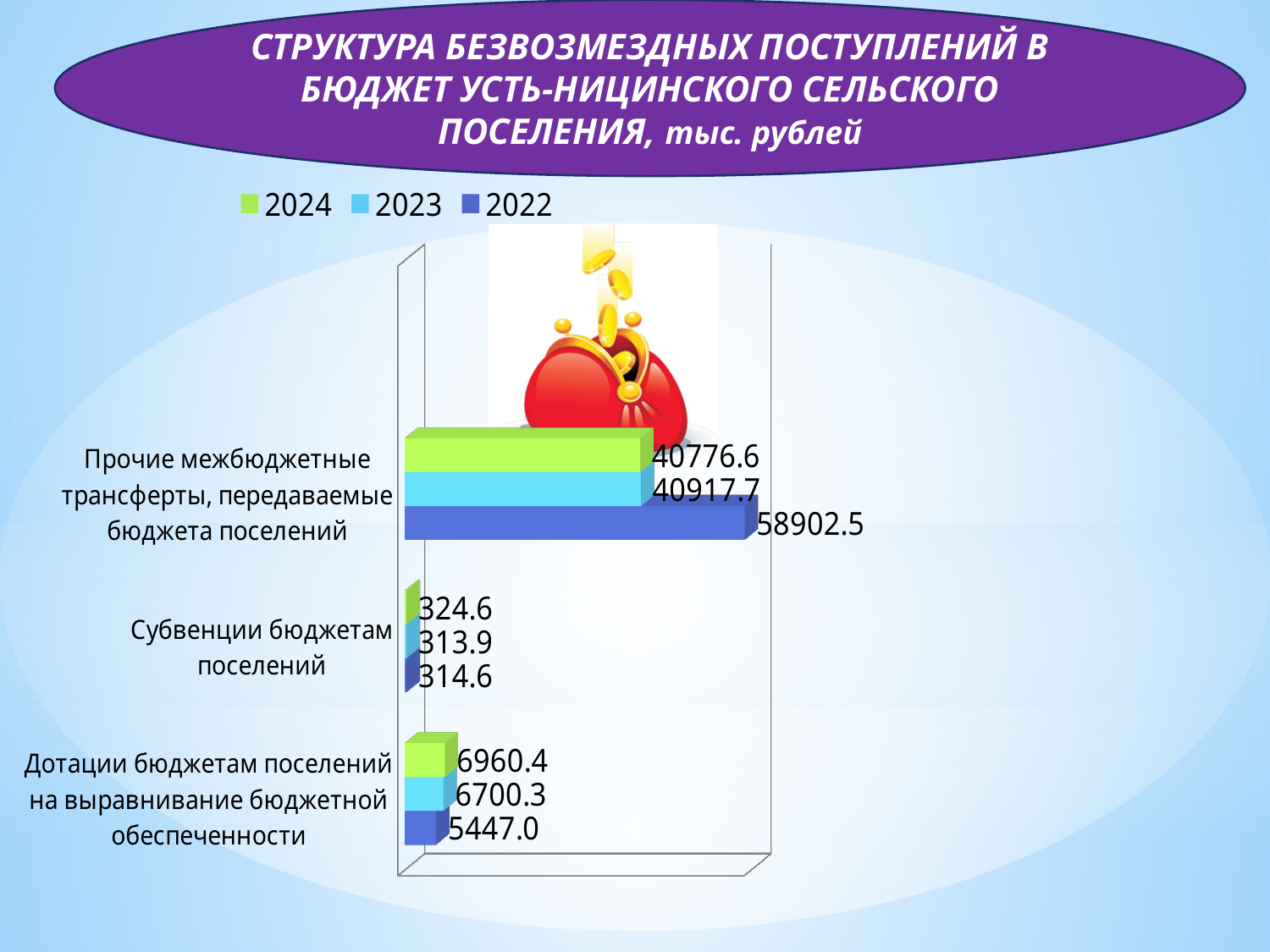
Which category has the highest 2024 value? Прочие межбюджетные трансферты, передаваемые бюджета поселений How many categories are shown in the chart? 3 What is the 2024 value for «Субвенции бюджетам поселений»? 324.6 What is the difference between the 2024 and 2022 values for «Дотации бюджетам поселений на выравнивание бюджетной обеспеченности»? 1513.4 What kind of chart is shown on the slide? Bar chart For «Дотации бюджетам поселений на выравнивание бюджетной обеспеченности», which year has the larger value, 2024 or 2022? 2024 Which series is shown in green in the legend? 2024 Which category has the lowest 2022 value? Субвенции бюджетам поселений What is the 2023 value for «Дотации бюджетам поселений на выравнивание бюджетной обеспеченности»? 6700.3 How many series does the legend list? 3 What is the 2022 value for «Прочие межбюджетные трансферты, передаваемые бюджета поселений»? 58902.5 What is the difference between the 2022 and 2023 values for «Прочие межбюджетные трансферты, передаваемые бюджета поселений»? 17984.8